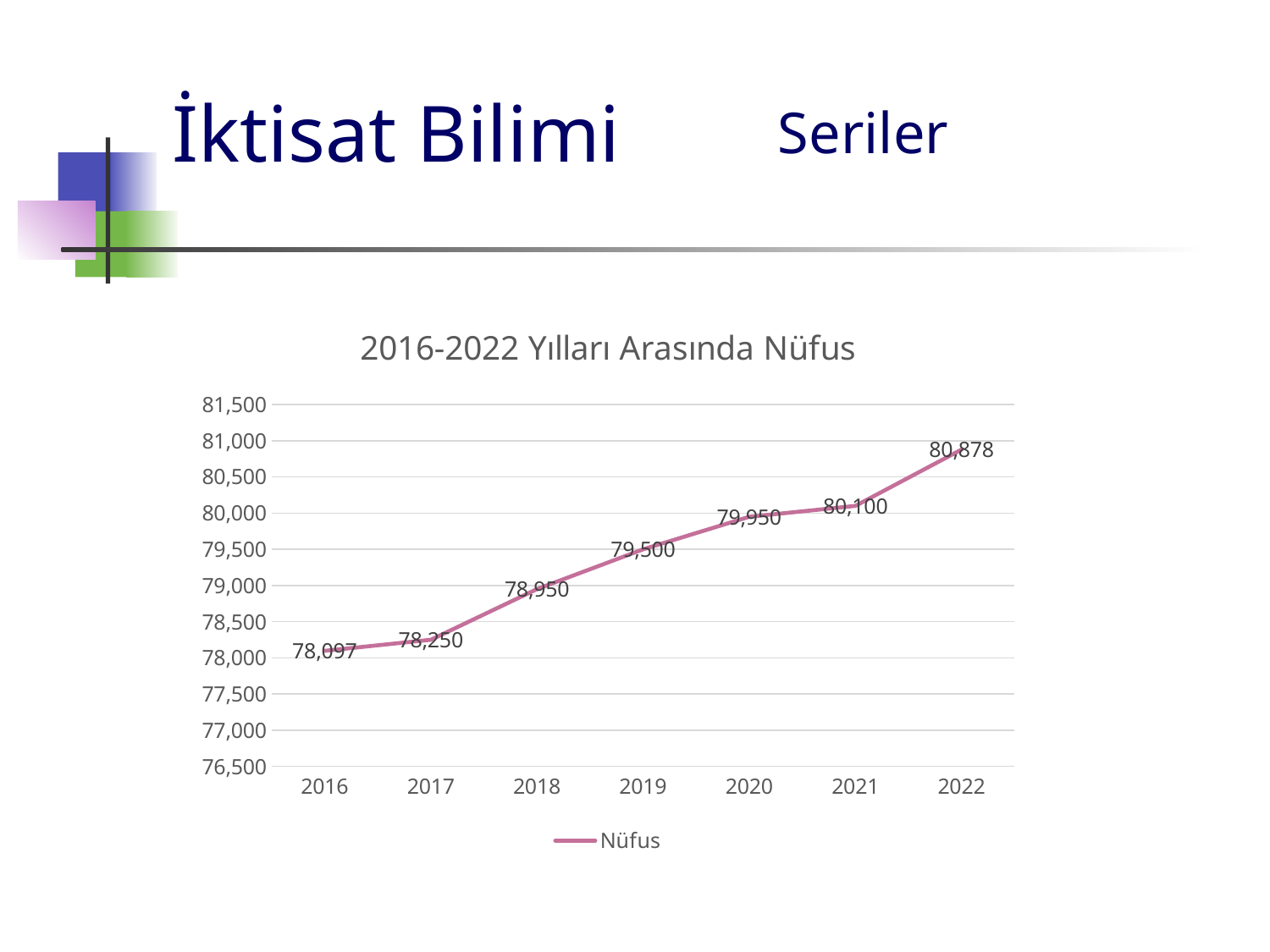
What is the population value for 2022? 80,878 How many years are plotted on the chart? 7 Which is larger, the population value for 2020 or for 2019? 2020 What is the difference between the population values for 2022 and 2021? 778 What kind of chart is shown on the slide? line chart What is the population value for 2019? 79,500 Which year has the highest population value? 2022 Is the population value for 2021 greater or less than 80,000? greater Do the population values rise or fall from 2016 to 2022? rise What is the population value for 2016? 78,097 Which year has the lowest population value? 2016 What is the difference between the population values for 2018 and 2017? 700